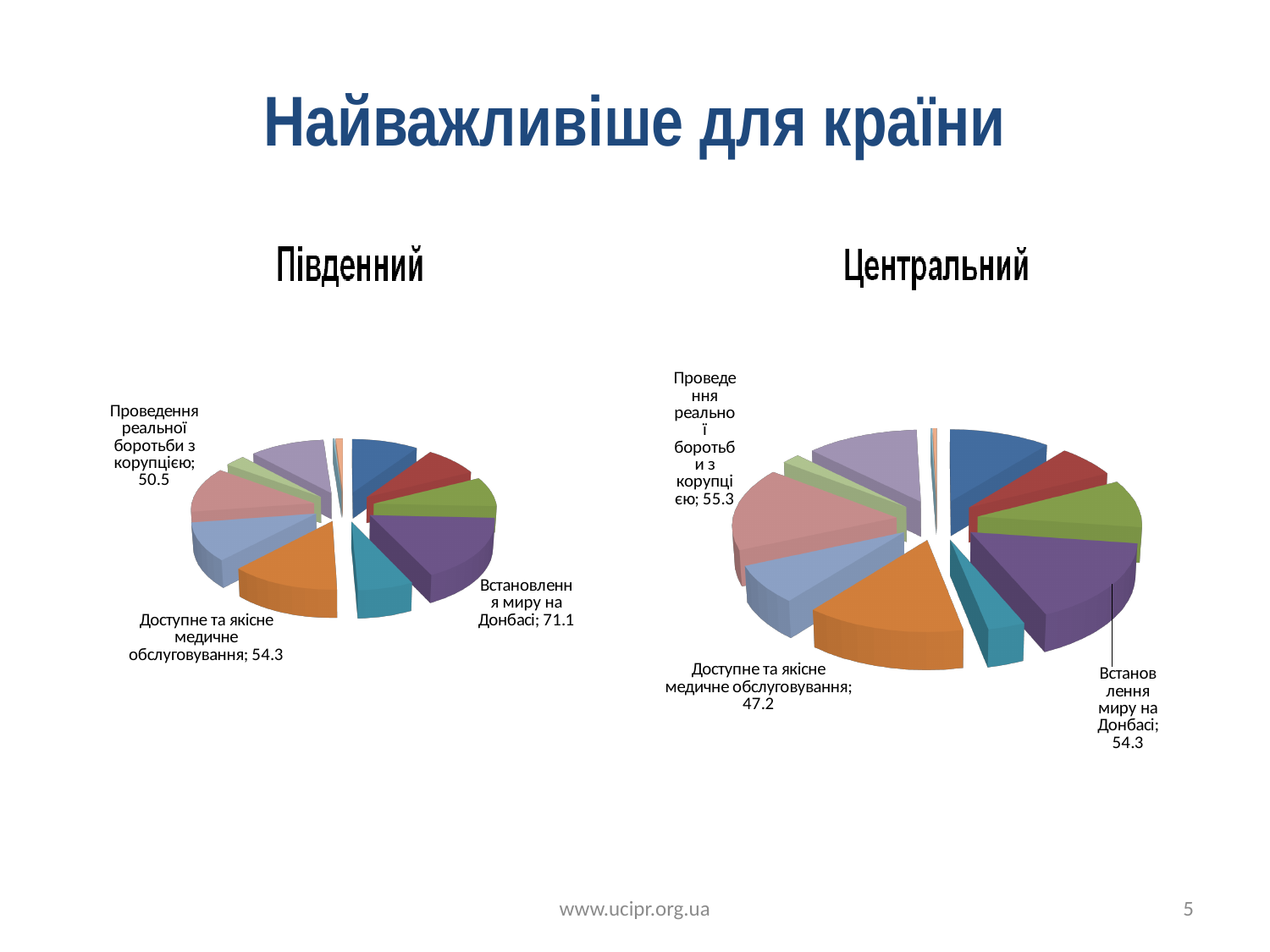
In the Південний chart, what is the value for Доступне та якісне медичне обслуговування? 54.3 What kind of chart is the Південний chart? Pie chart In the Центральний chart, which is larger: Встановлення миру на Донбасі or Доступне та якісне медичне обслуговування? Встановлення миру на Донбасі In the Південний chart, what is the difference between the values for Встановлення миру на Донбасі and Доступне та якісне медичне обслуговування? 16.8 In the Центральний chart, what is the value for Доступне та якісне медичне обслуговування? 47.2 In the Південний chart, what is the value for Встановлення миру на Донбасі? 71.1 In the Центральний chart, what is the value for Проведення реальної боротьби з корупцією? 55.3 What are the titles of the two charts on the slide? Південний and Центральний In the Південний chart, what is the value for Проведення реальної боротьби з корупцією? 50.5 In the Південний chart, which is larger: Проведення реальної боротьби з корупцією or Доступне та якісне медичне обслуговування? Доступне та якісне медичне обслуговування In the Центральний chart, what is the value for Встановлення миру на Донбасі? 54.3 In the Центральний chart, what is the difference between the values for Проведення реальної боротьби з корупцією and Доступне та якісне медичне обслуговування? 8.1